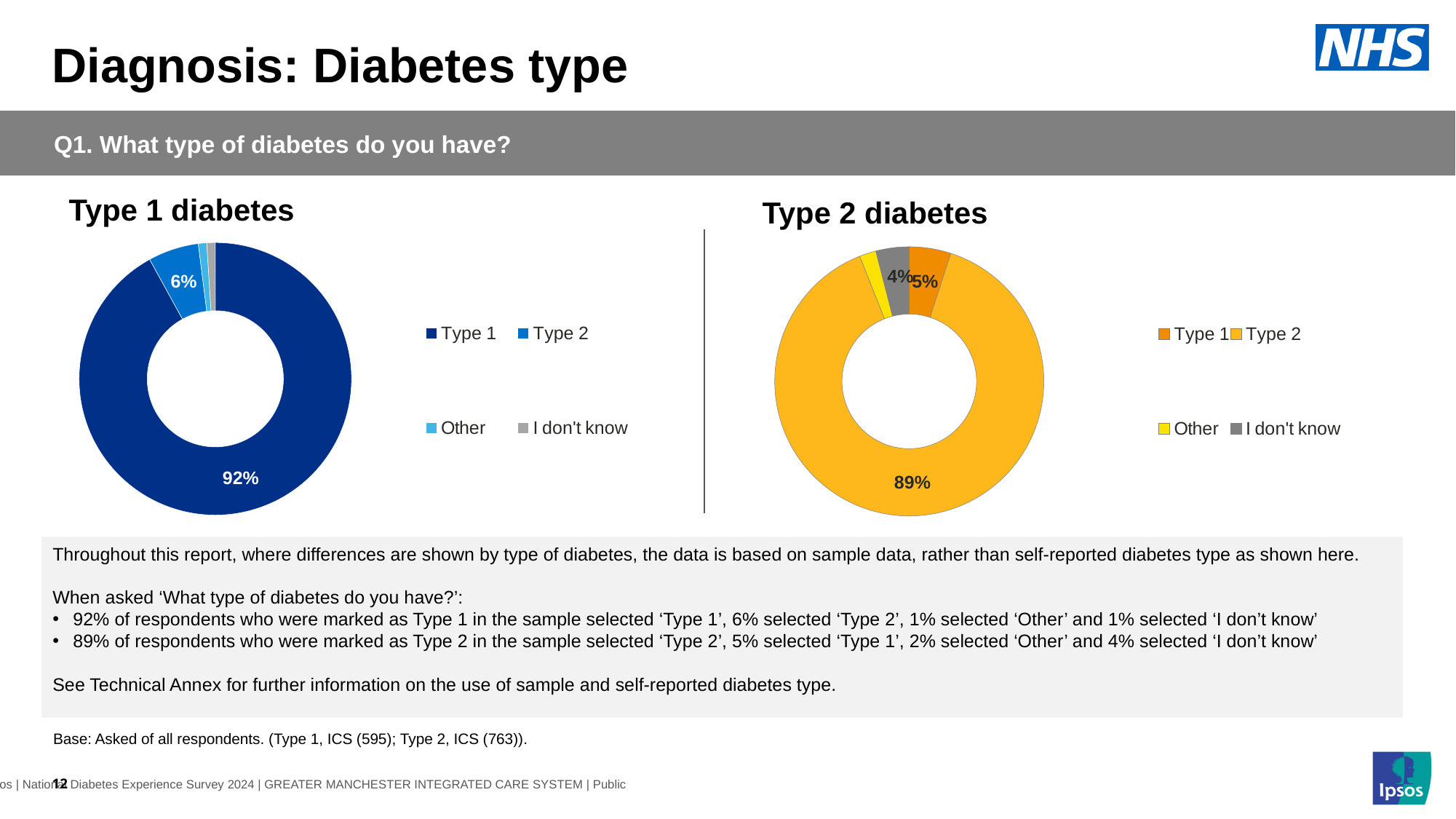
In the 'Type 1 diabetes' chart, what share of respondents selected 'Type 1'? 92% In the 'Type 2 diabetes' chart, what share of respondents selected 'Type 1'? 5% In the 'Type 2 diabetes' chart, what share of respondents selected 'Type 2'? 89% In the 'Type 2 diabetes' chart, what share of respondents selected 'I don't know'? 4% In the 'Type 2 diabetes' chart, which category has the largest slice? Type 2 What colour is the 'Type 2' slice in the 'Type 2 diabetes' chart? Yellow-orange In the 'Type 1 diabetes' chart, which category has the largest slice? Type 1 What kind of chart is used on this slide? Donut (pie) chart In the 'Type 1 diabetes' chart, what is the difference between the 'Type 1' and 'Type 2' shares? 86% How many categories does the legend of the 'Type 1 diabetes' chart list? 4 In the 'Type 1 diabetes' chart, what share of respondents selected 'Type 2'? 6% In the 'Type 2 diabetes' chart, which is larger: the 'Type 1' slice or the 'I don't know' slice? Type 1